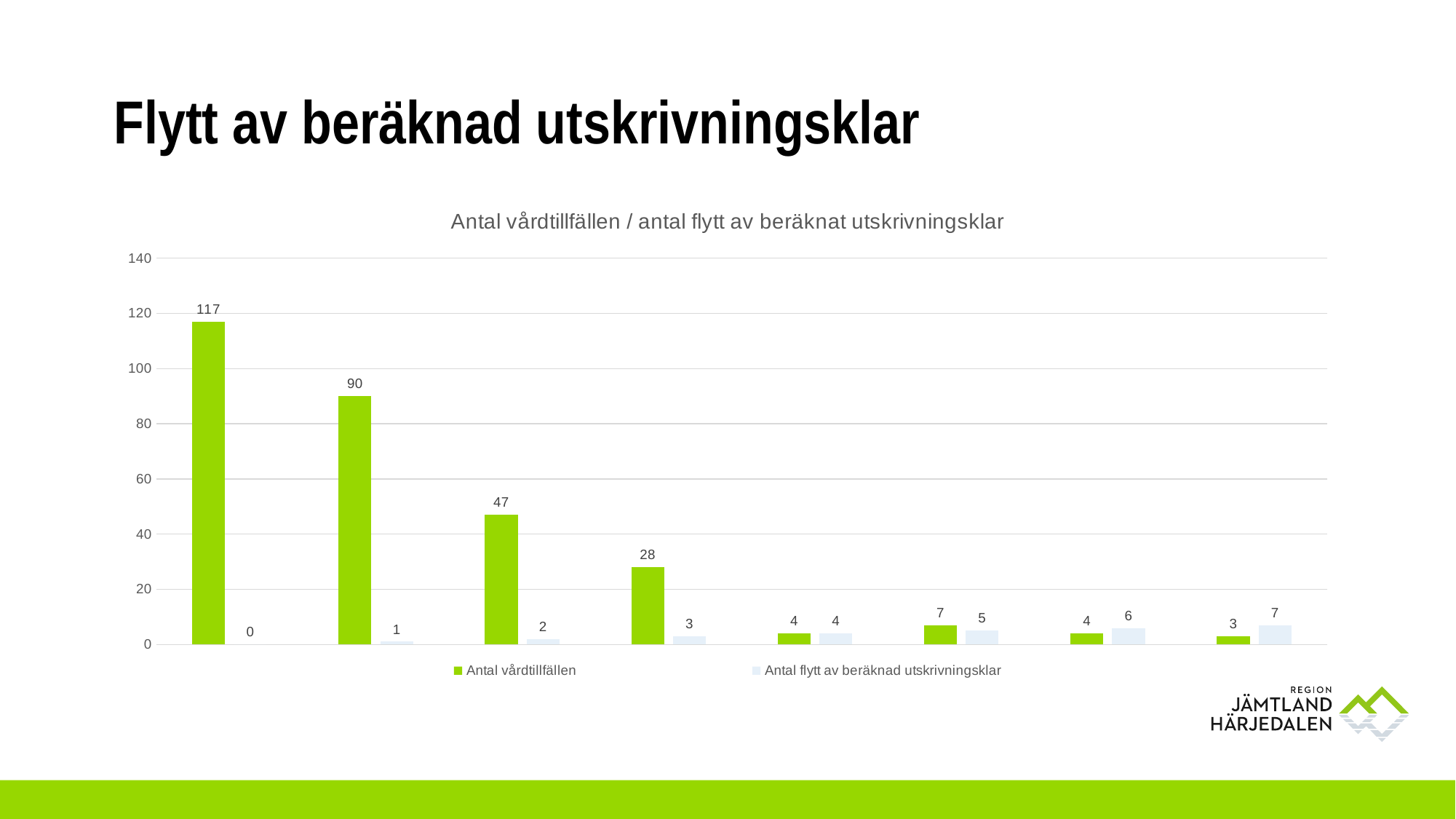
What is the chart's title? Antal vårdtillfällen / antal flytt av beräknat utskrivningsklar Do the values of the Antal flytt av beräknad utskrivningsklar series rise or fall from left to right along the x axis? Rise How many series does the chart legend list? 2 What is the highest value plotted for the Antal vårdtillfällen series? 117 What is the value of Antal flytt av beräknad utskrivningsklar for the last (rightmost) group of bars? 7 What is the value of Antal vårdtillfällen for the first (leftmost) group of bars? 117 What type of chart is shown on the slide? Bar chart In the second group of bars, what is the difference between Antal vårdtillfällen (90) and Antal flytt av beräknad utskrivningsklar (1)? 89 In the rightmost group of bars, which series has the larger value: Antal vårdtillfällen or Antal flytt av beräknad utskrivningsklar? Antal flytt av beräknad utskrivningsklar How many groups of bars are plotted along the x axis? 8 What is the lowest value plotted for the Antal flytt av beräknad utskrivningsklar series? 0 Is the value of Antal vårdtillfällen for the third group of bars greater or less than 60? less